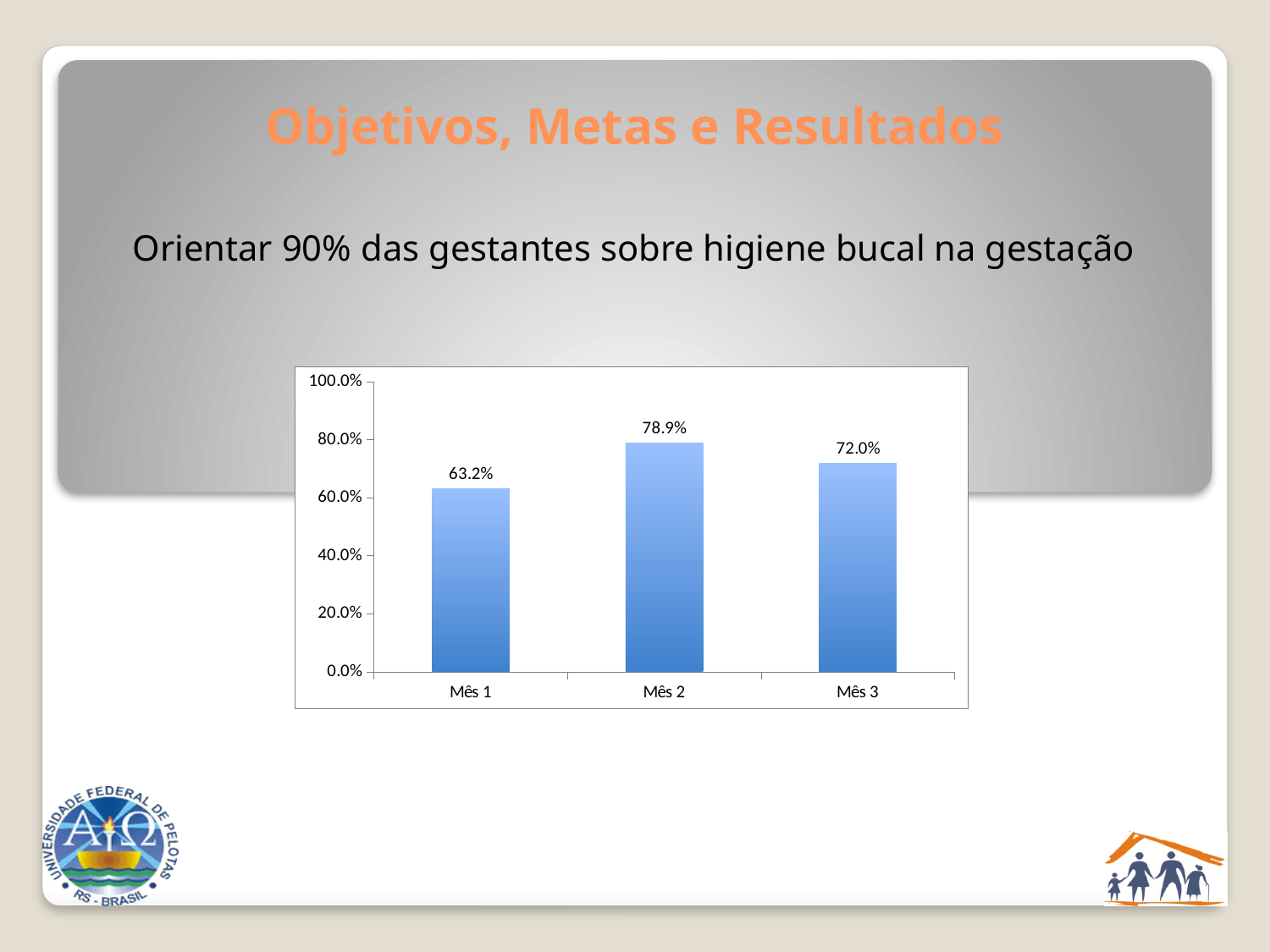
How many months are shown on the x axis? 3 What is the maximum value shown on the y axis? 100.0% Which month has the highest value? Mês 2 What is the value for Mês 2? 78.9% Which month has the lowest value? Mês 1 What is the difference between the values for Mês 2 and Mês 3? 6.9% What kind of chart is shown on the slide? bar chart What is the difference between the values for Mês 2 and Mês 1? 15.7% Is the value for Mês 2 greater or less than 80.0%? less Which is larger, the value for Mês 3 or the value for Mês 1? Mês 3 What is the value for Mês 3? 72.0% What is the value for Mês 1? 63.2%